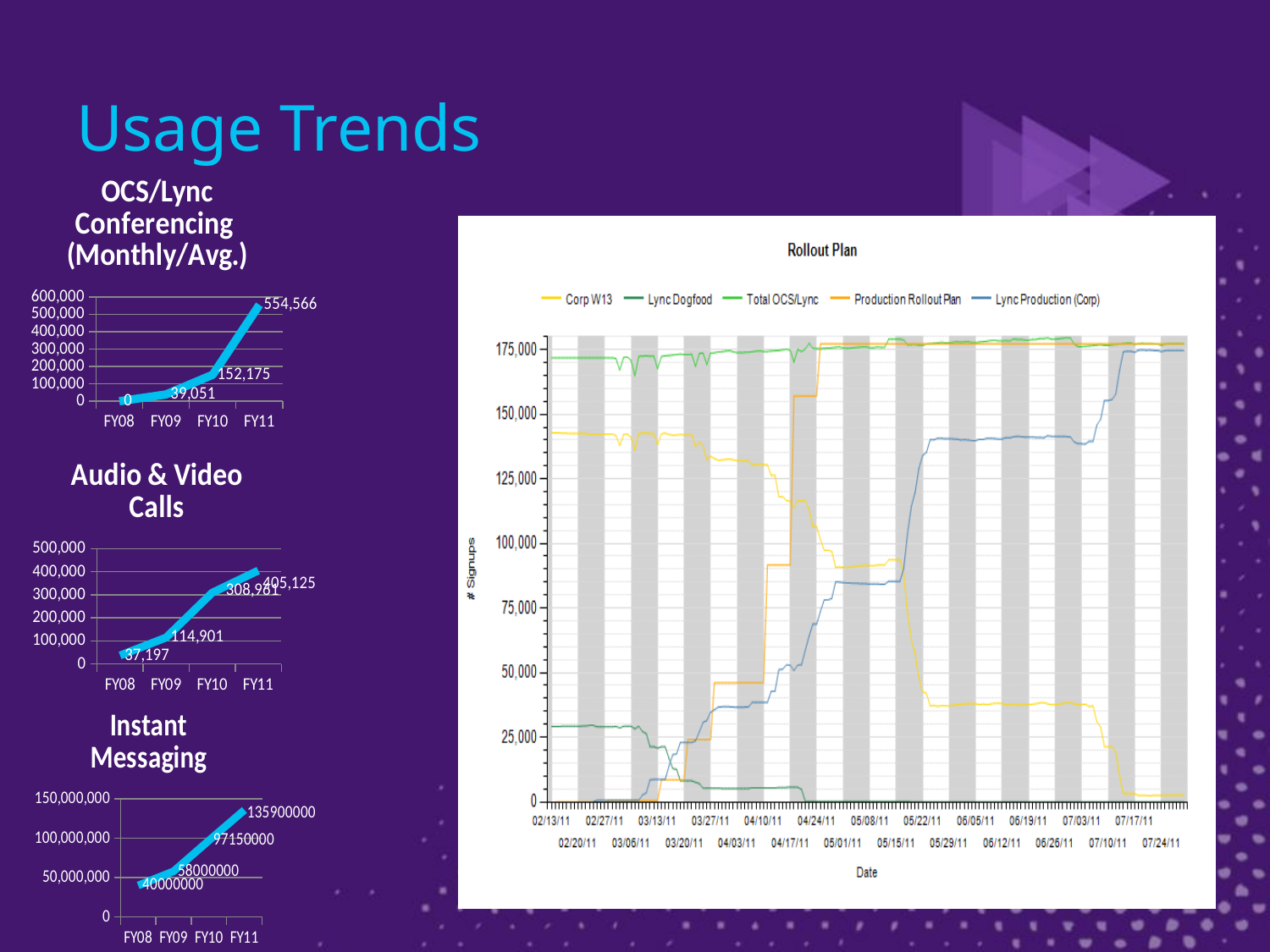
In the OCS/Lync Conferencing (Monthly/Avg.) chart, what is the difference between the FY11 and FY10 values? 402,391 In the OCS/Lync Conferencing (Monthly/Avg.) chart, what is the value for FY09? 39,051 What kind of chart is the Rollout Plan chart? line chart In the Audio & Video Calls chart, which fiscal year has the lowest value? FY08 In the Instant Messaging chart, which fiscal year has the highest value? FY11 In the Instant Messaging chart, how many fiscal years are plotted on the x axis? 4 How many series does the legend of the Rollout Plan chart list? 5 In the Instant Messaging chart, what is the value for FY09? 58000000 In the Audio & Video Calls chart, what is the value for FY10? 308,961 In the Rollout Plan chart, is the value of the Total OCS/Lync series on 02/13/11 greater or less than 150,000? greater In the OCS/Lync Conferencing (Monthly/Avg.) chart, what is the value for FY11? 554,566 In the Audio & Video Calls chart, do the values rise or fall from FY08 to FY11? rise